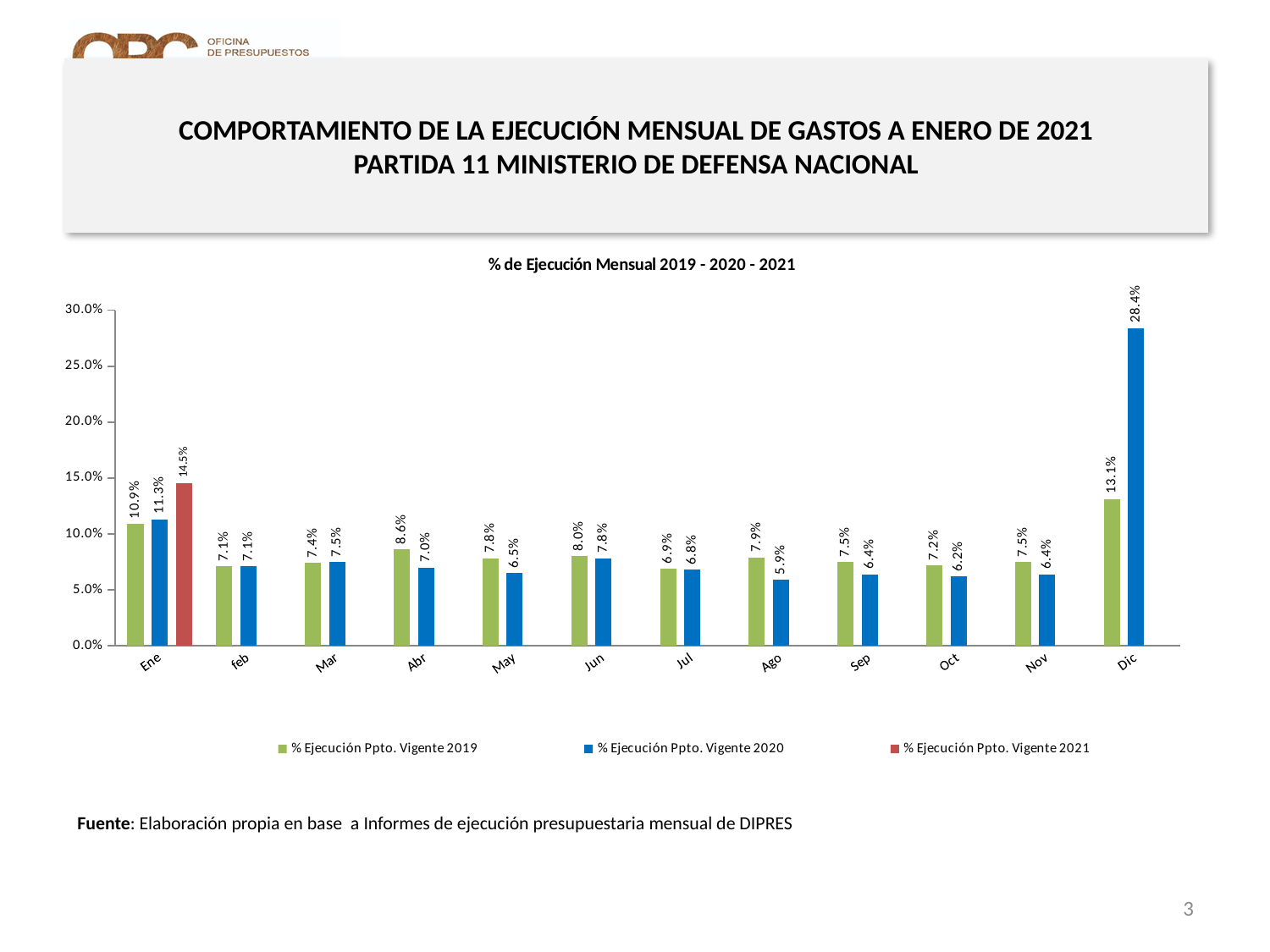
What kind of chart is shown on the slide? Bar chart How many months are shown on the x axis? 12 Which month has the highest value in the % Ejecución Ppto. Vigente 2020 series? Dic What is the value for Abr in the % Ejecución Ppto. Vigente 2019 series? 8.6% What is the value for Ene in the % Ejecución Ppto. Vigente 2021 series? 14.5% What is the title of the chart? % de Ejecución Mensual 2019 - 2020 - 2021 What is the difference between the 2020 and 2019 values for Dic? 15.3% Which is larger for Ago: the % Ejecución Ppto. Vigente 2019 value or the % Ejecución Ppto. Vigente 2020 value? % Ejecución Ppto. Vigente 2019 Which month has the lowest value in the % Ejecución Ppto. Vigente 2020 series? Ago Is the value for Dic in the % Ejecución Ppto. Vigente 2020 series greater or less than 25.0%? greater What is the value for Dic in the % Ejecución Ppto. Vigente 2020 series? 28.4% How many series does the legend list? 3